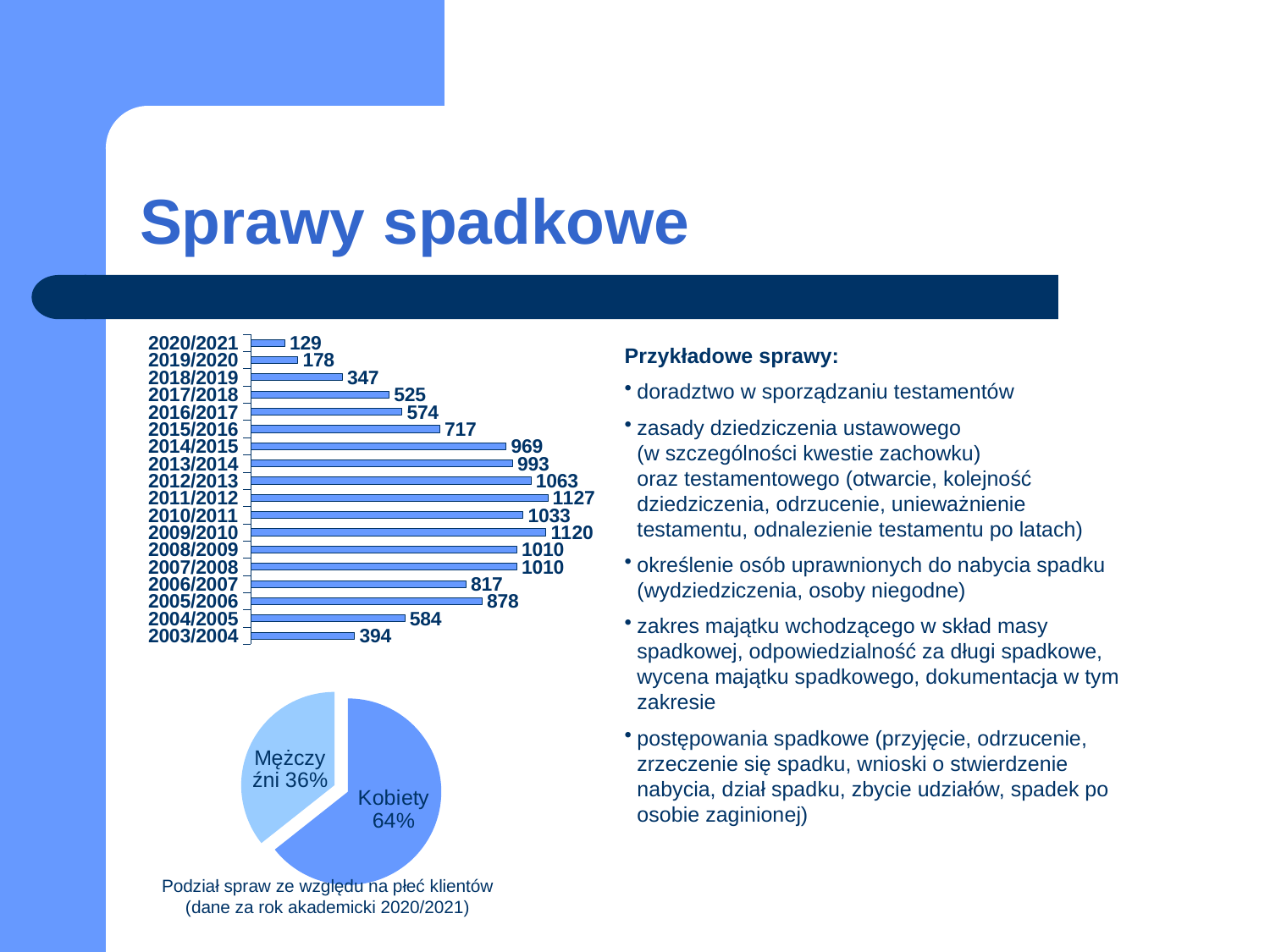
In the bar chart, what is the value for 2011/2012? 1127 In the pie chart, how many slices are there? 2 In the bar chart, which is larger, the value for 2013/2014 or the value for 2014/2015? 2013/2014 In the bar chart, which year has the highest value? 2011/2012 In the bar chart, what is the value for 2003/2004? 394 In the bar chart, which year has the lowest value? 2020/2021 In the bar chart, what is the difference between the values for 2019/2020 and 2020/2021? 49 In the bar chart, how many years are shown? 18 In the pie chart, what share is labelled Mężczyźni? 36% In the bar chart, what is the value for 2016/2017? 574 In the pie chart, what share is labelled Kobiety? 64% What kind of chart is the upper chart on the slide? bar chart